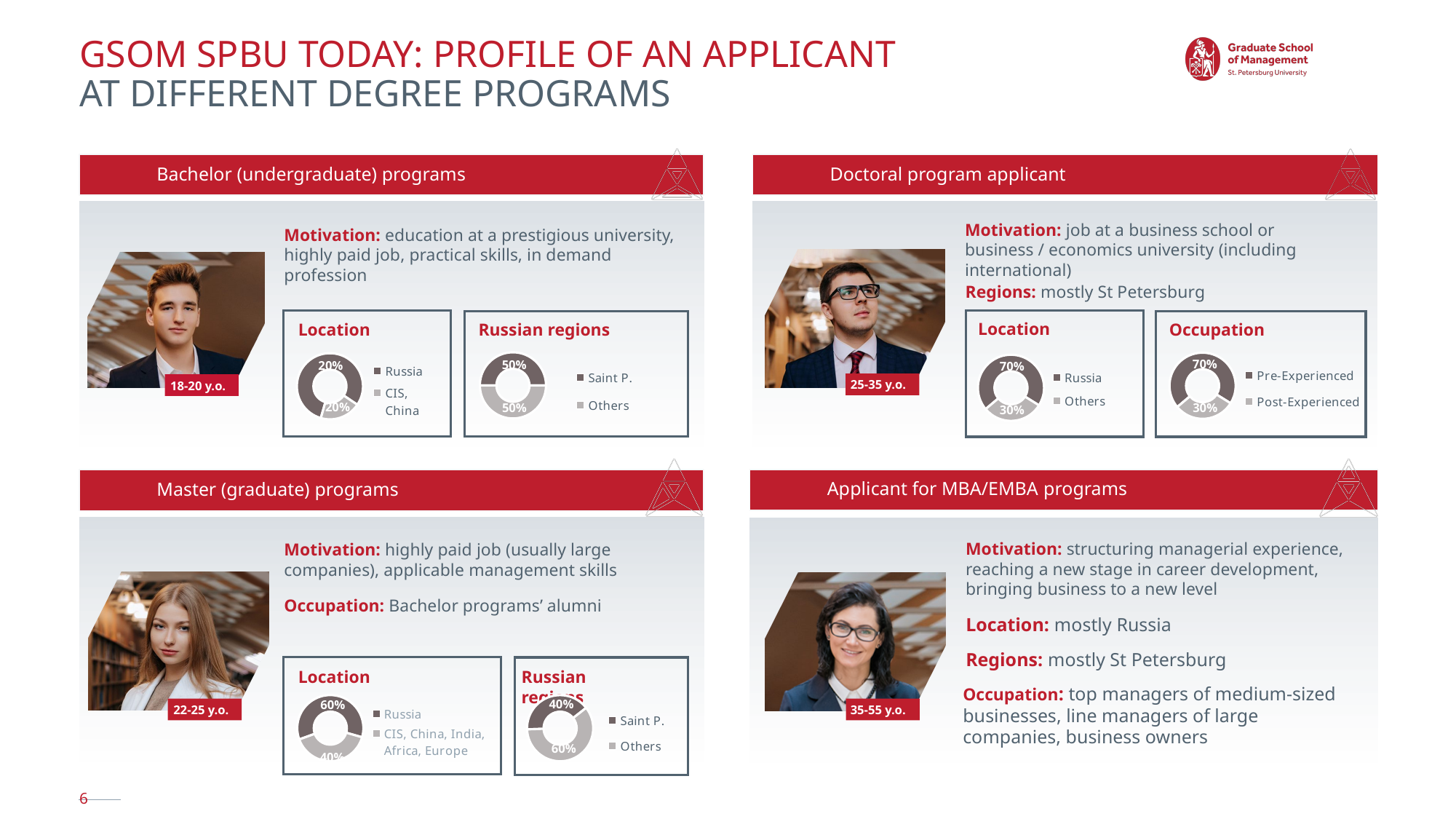
In the Bachelor (undergraduate) programs 'Russian regions' chart, what share is Saint P.? 50% What kind of chart is used in the 'Location' box of the Doctoral program applicant section? Pie (donut) chart In the Doctoral program applicant 'Location' chart, what share is Others? 30% In the Doctoral program applicant 'Location' chart, what share is Russia? 70% In the Master (graduate) programs 'Russian regions' chart, what share is Saint P.? 40% In the Doctoral program applicant 'Location' chart, what is the difference between the Russia and Others shares? 40% In the Doctoral program applicant 'Occupation' chart, what share is Pre-Experienced? 70% In the Master (graduate) programs 'Location' chart, what share is Russia? 60% In the Bachelor (undergraduate) programs 'Location' chart, which is larger, Russia or CIS, China? Russia In the Master (graduate) programs 'Location' chart, how many categories does the legend list? 2 In the Doctoral program applicant 'Occupation' chart, what share is Post-Experienced? 30% In the Master (graduate) programs 'Russian regions' chart, which is larger, Saint P. or Others? Others